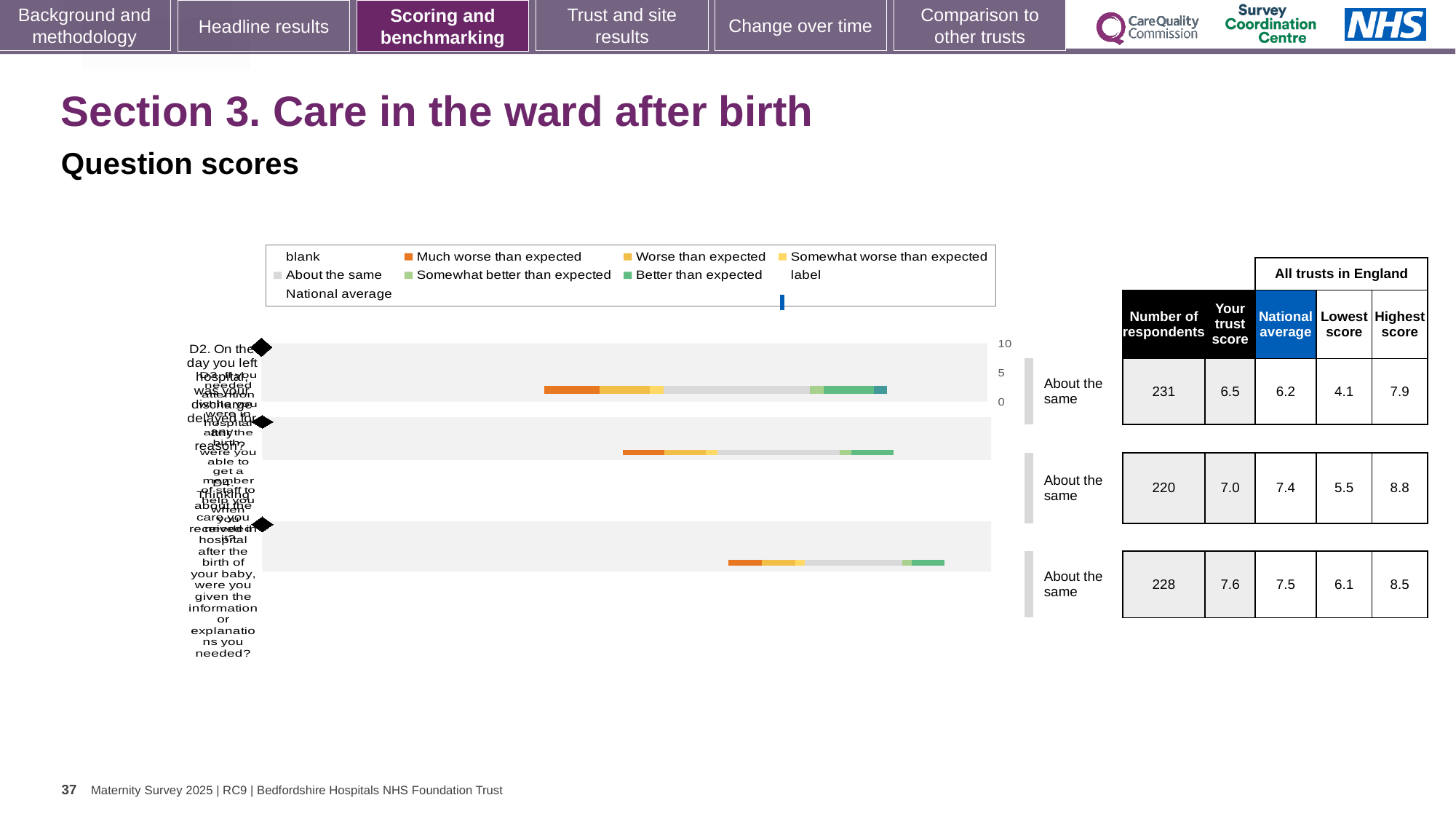
In the table beside the chart, what is the highest score for the bottom row? 8.5 In the table beside the chart, what is the number of respondents for the top row? 231 For the bottom row, what is the difference between the highest score and the lowest score? 2.4 For the middle row, which is larger: 'Your trust score' or the national average? National average What benchmark label is shown next to each of the three bars? About the same How many stacked bars are plotted in the chart? 3 In the chart legend, what colour represents 'Better than expected'? green Which row has the highest number of respondents? the top row (231) What kind of chart is shown on the slide? bar chart In the table beside the chart, what is 'Your trust score' for the top row? 6.5 In the table beside the chart, what is the national average for the middle row? 7.4 In the chart legend, what colour represents 'Much worse than expected'? orange